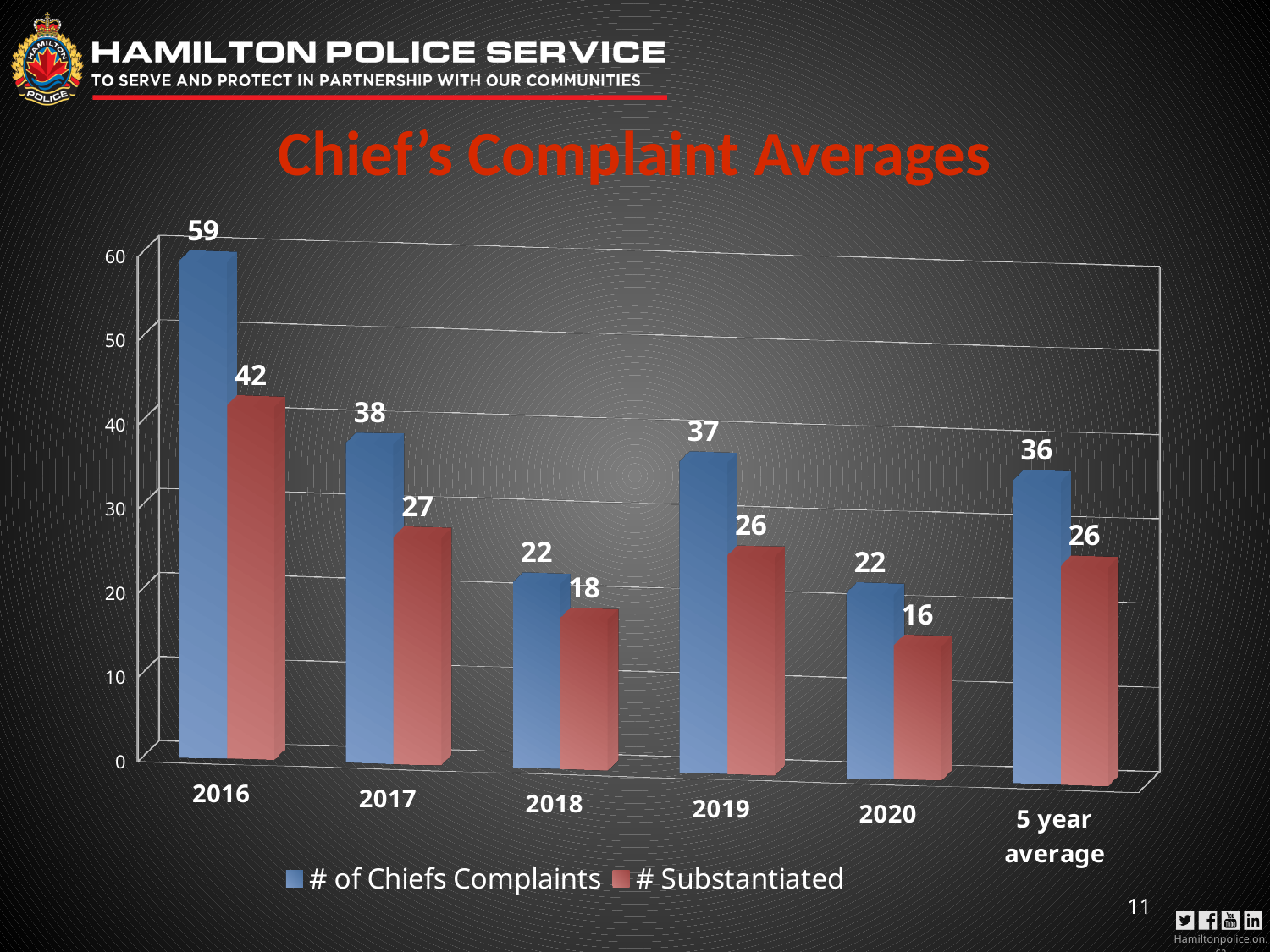
How many categories are shown on the x axis? 6 Which year has the highest number of Chiefs Complaints? 2016 Which is larger: # Substantiated in 2019 or # Substantiated in 2018? 2019 What is the difference between # of Chiefs Complaints and # Substantiated in 2017? 11 What is the title of the chart? Chief's Complaint Averages What is the number Substantiated in 2020? 16 What is the 5 year average for # of Chiefs Complaints? 36 What kind of chart is shown on the slide? bar chart Which category has the lowest # Substantiated value? 2020 What is the number of Chiefs Complaints in 2016? 59 How many series does the legend list? 2 Do the # of Chiefs Complaints values rise or fall from 2016 to 2018? fall